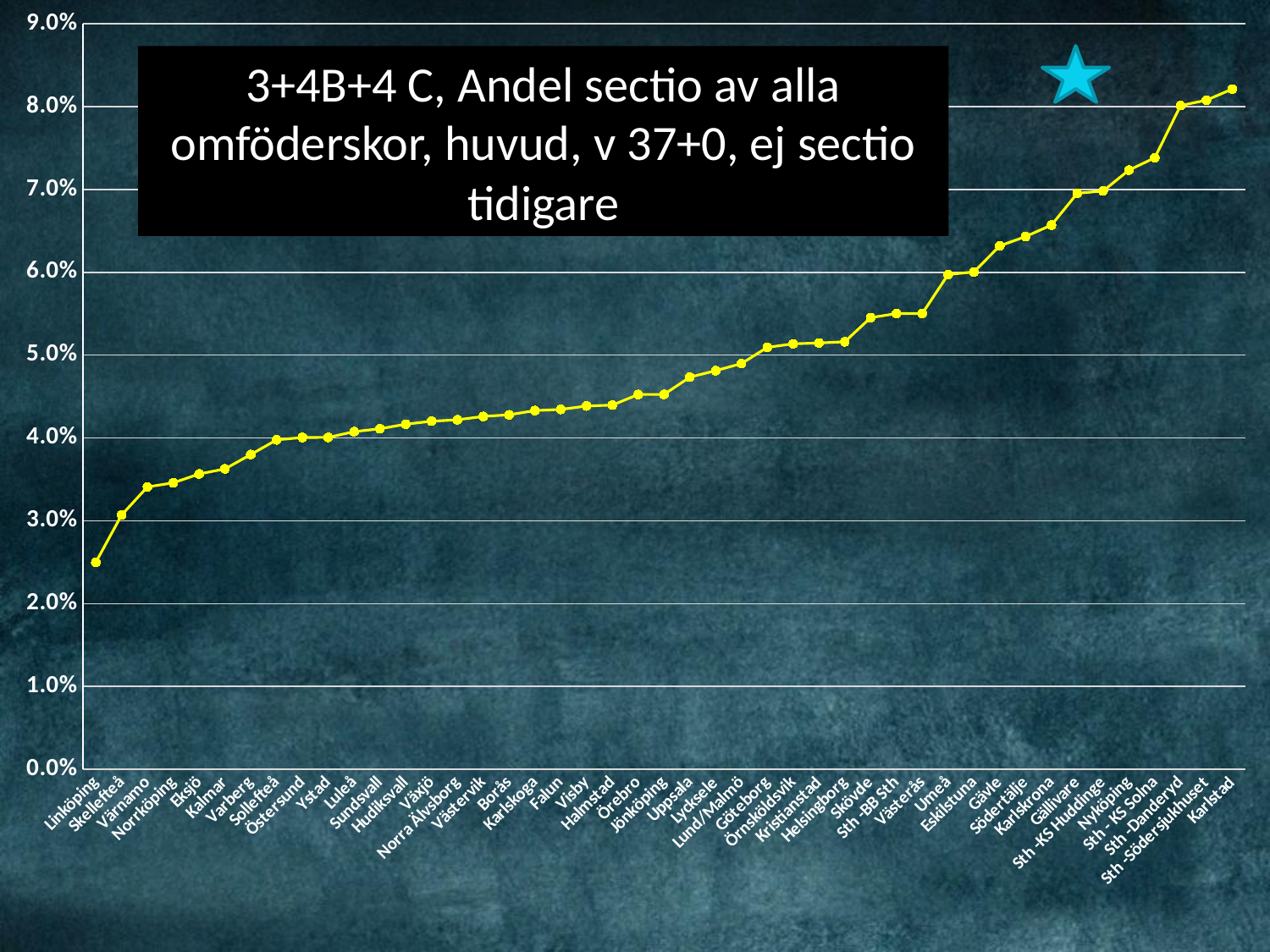
Which category has the lowest value? Linköping How many categories are plotted on the x axis? 45 Which has a larger value, Nyköping or Borås? Nyköping What kind of chart is shown on the slide? line chart Which category has the highest value? Karlstad Is the value for Linköping greater or less than 3.0%? less Is the value for Nyköping greater or less than 7.0%? greater Do the values rise or fall from left to right along the x axis? rise Is the value for Uppsala greater or less than 5.0%? less What is the title of the chart? 3+4B+4 C, Andel sectio av alla omföderskor, huvud, v 37+0, ej sectio tidigare